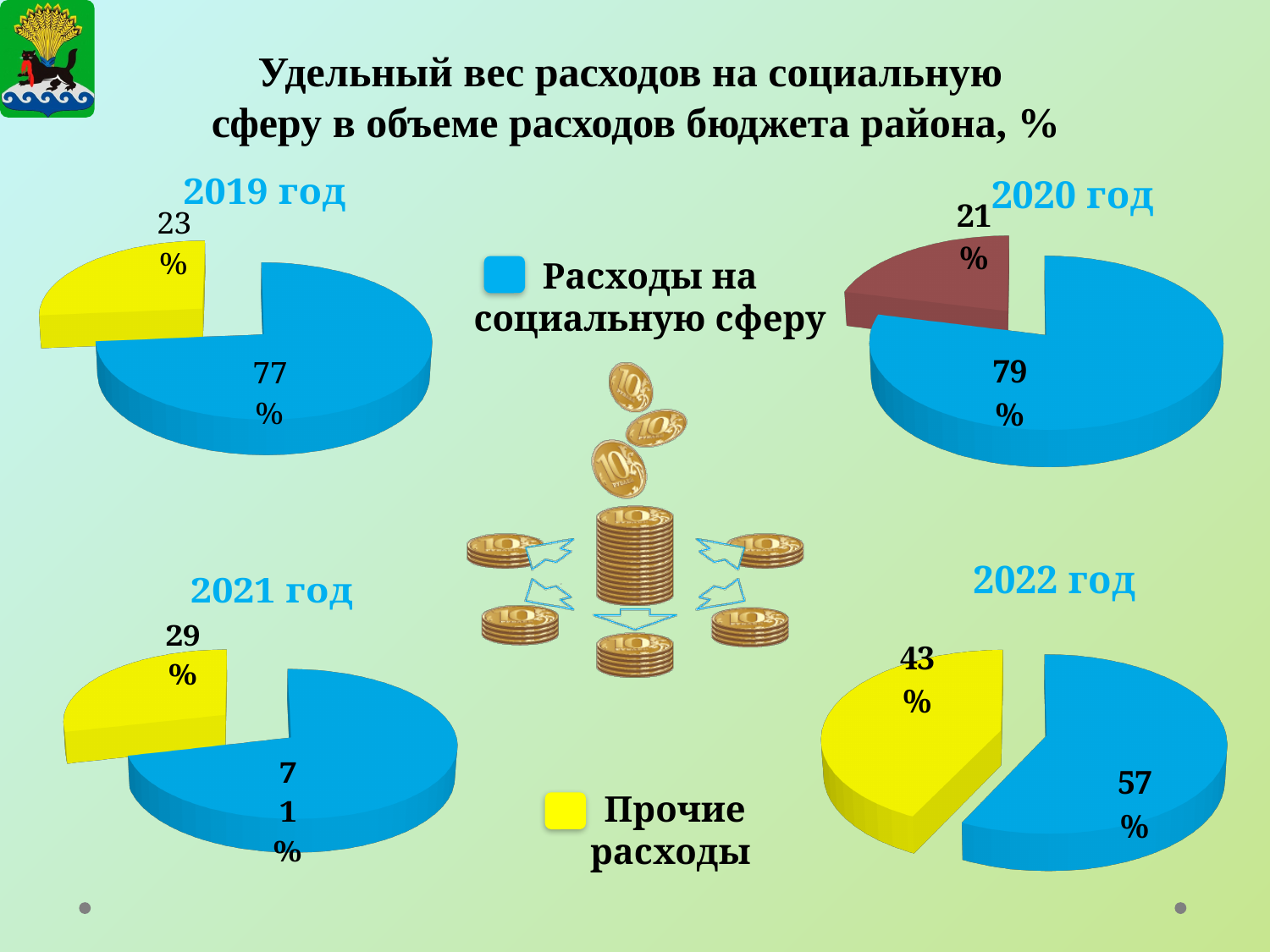
In the 2022 год pie chart, what share is labelled for Расходы на социальную сферу? 57% In the 2019 год pie chart, what share is labelled for Прочие расходы? 23% In the 2022 год pie chart, what share is labelled for Прочие расходы? 43% What is the difference between the Расходы на социальную сферу share in the 2020 год chart and in the 2022 год chart? 22% In the 2019 год pie chart, what share is labelled for Расходы на социальную сферу? 77% In the 2021 год pie chart, what share is labelled for Прочие расходы? 29% How many pie charts are shown on the slide? 4 What type of chart is used for each year on this slide? Pie chart Across the four pie charts, which year shows the highest share for Расходы на социальную сферу? 2020 год Which is larger: the Прочие расходы share in the 2021 год chart or in the 2019 год chart? 2021 год In the 2020 год pie chart, what share is labelled for Расходы на социальную сферу? 79% Across the four pie charts, which year shows the lowest share for Расходы на социальную сферу? 2022 год